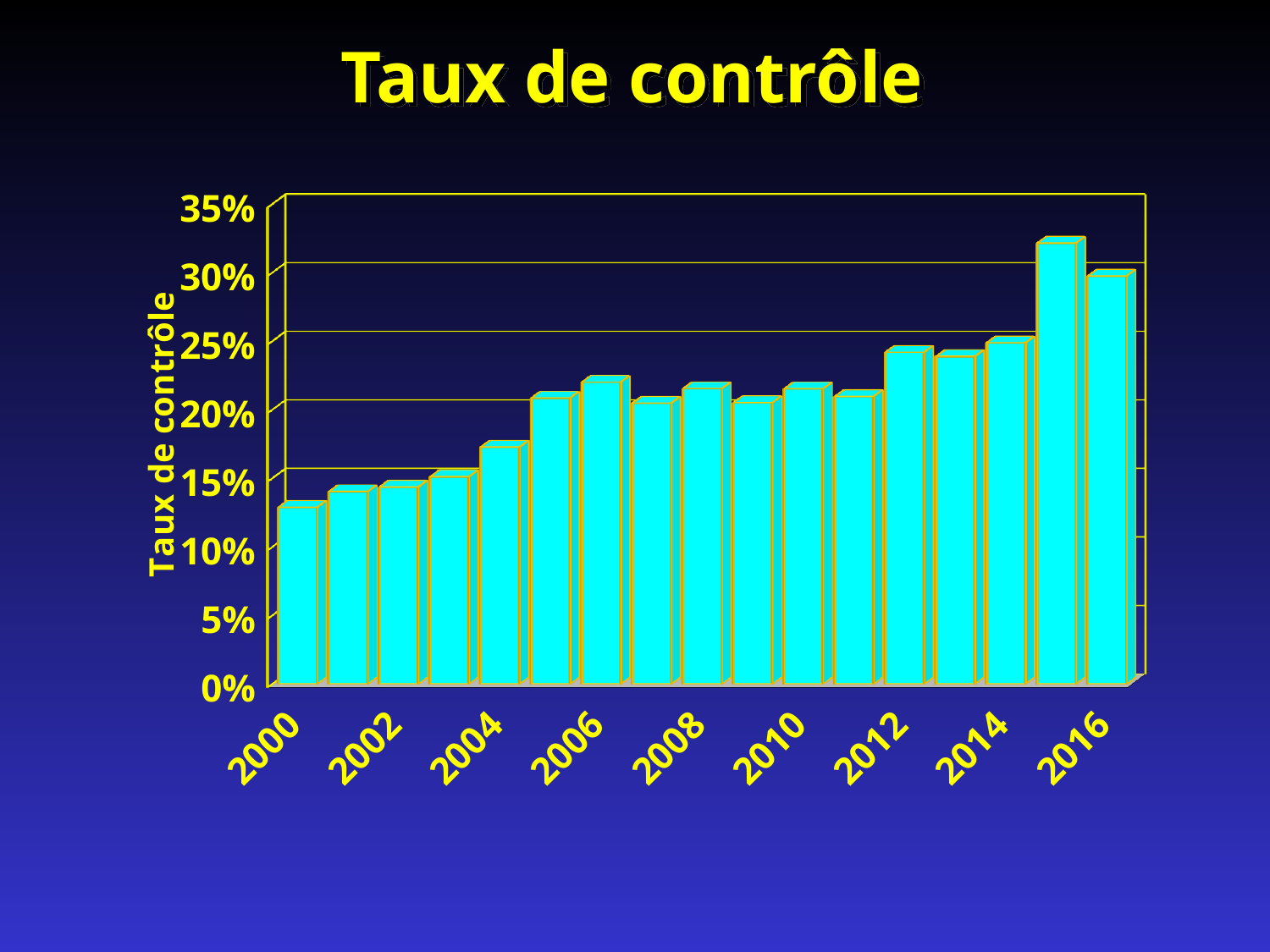
Is the value for 2006 greater or less than 20%? greater What type of chart is shown on the slide? bar chart What is the label of the vertical axis? Taux de contrôle Which year has the highest taux de contrôle? 2015 Overall, do the values rise or fall from 2000 to 2016? rise Which is larger, the value for 2015 or the value for 2016? 2015 Is the value for 2015 greater or less than 30%? greater Is the value for 2000 greater or less than 15%? less Which is larger, the value for 2010 or the value for 2012? 2012 What is the title of the chart? Taux de contrôle Which year has the lowest taux de contrôle? 2000